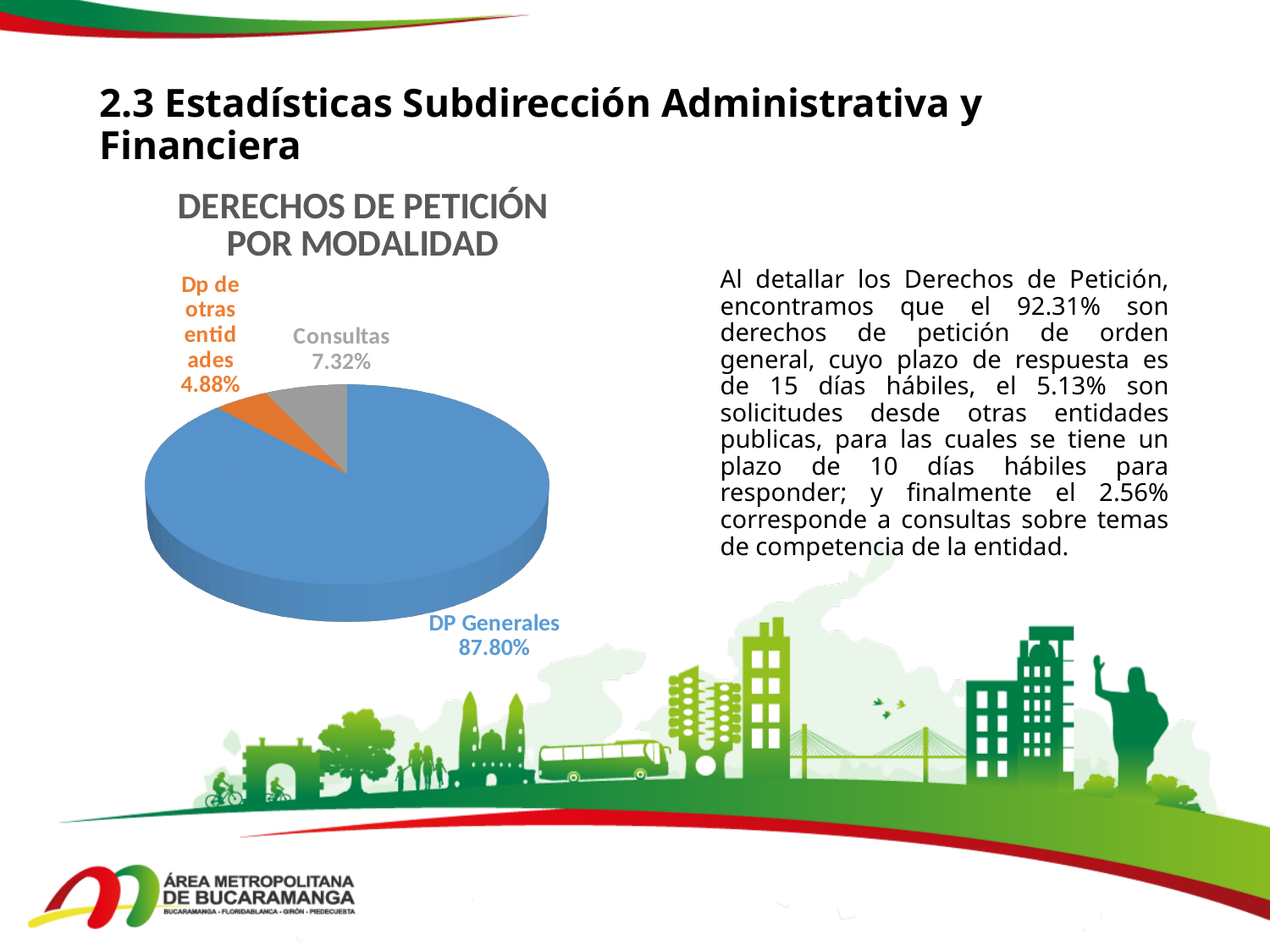
What kind of chart is shown on the slide? pie chart What is the title of the chart? DERECHOS DE PETICIÓN POR MODALIDAD What is the difference in percentage points between DP Generales and Consultas? 80.48 What colour is the DP Generales slice? blue What share of the pie is labelled for Dp de otras entidades? 4.88% What share of the pie is labelled for DP Generales? 87.80% What share of the pie is labelled for Consultas? 7.32% Which category has the largest slice of the pie? DP Generales Which is larger, the slice for Consultas or the slice for Dp de otras entidades? Consultas How many slices does the pie chart have? 3 Which category has the smallest slice of the pie? Dp de otras entidades What is the difference in percentage points between Consultas and Dp de otras entidades? 2.44